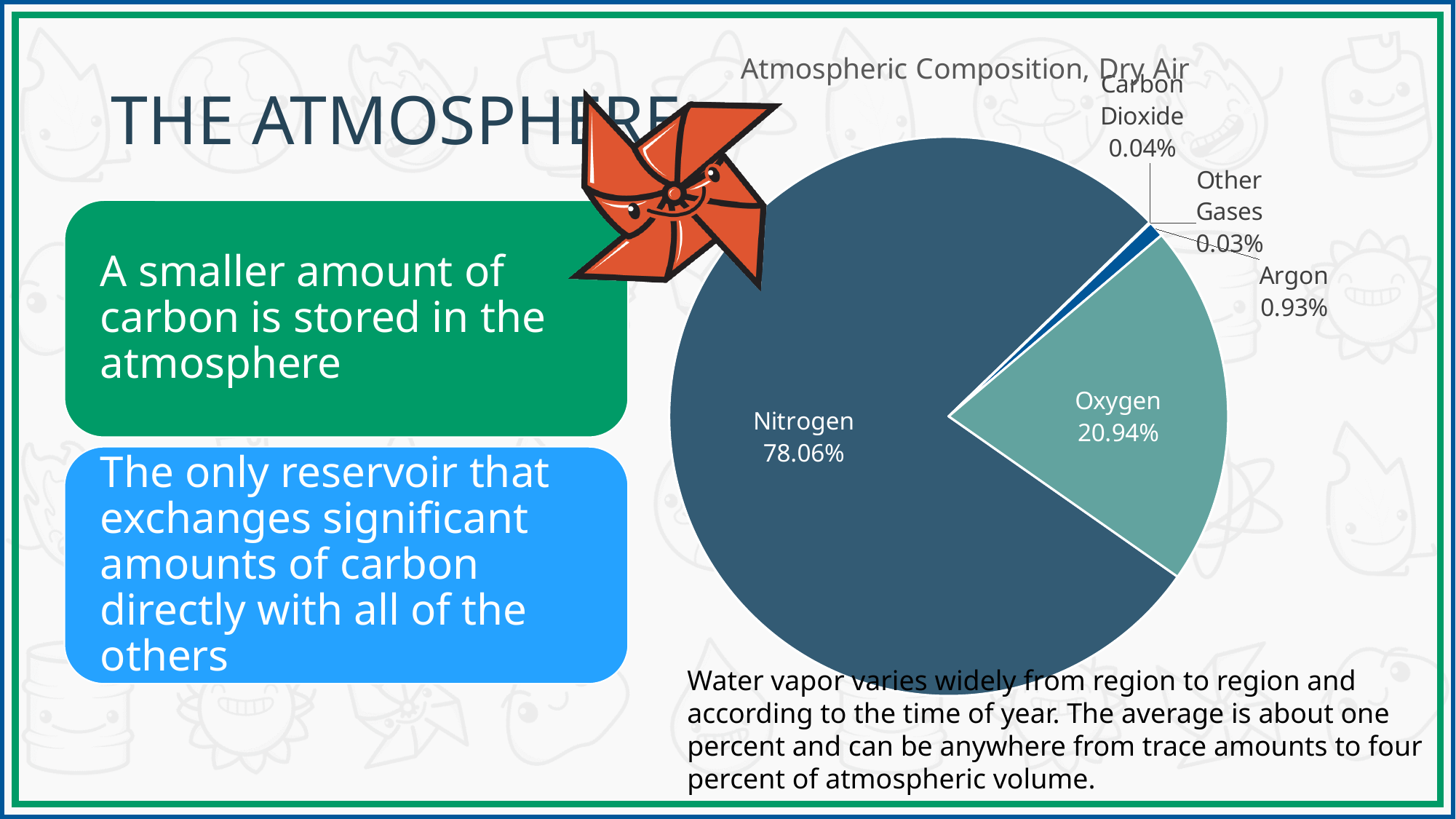
What is the difference between the Nitrogen and Oxygen percentages in the chart? 57.12% What percentage of dry air is Nitrogen according to the chart? 78.06% What is the title of the chart? Atmospheric Composition, Dry Air Which gas has the largest slice in the chart? Nitrogen What value is shown for Carbon Dioxide in the chart? 0.04% Which category has the smallest value in the chart? Other Gases What value is shown for Argon in the chart? 0.93% Which is larger in the chart, Oxygen or Argon? Oxygen What percentage of dry air is Oxygen according to the chart? 20.94% What value is shown for Other Gases in the chart? 0.03% How many slices does the pie chart have? 5 What kind of chart is shown on the slide? pie chart